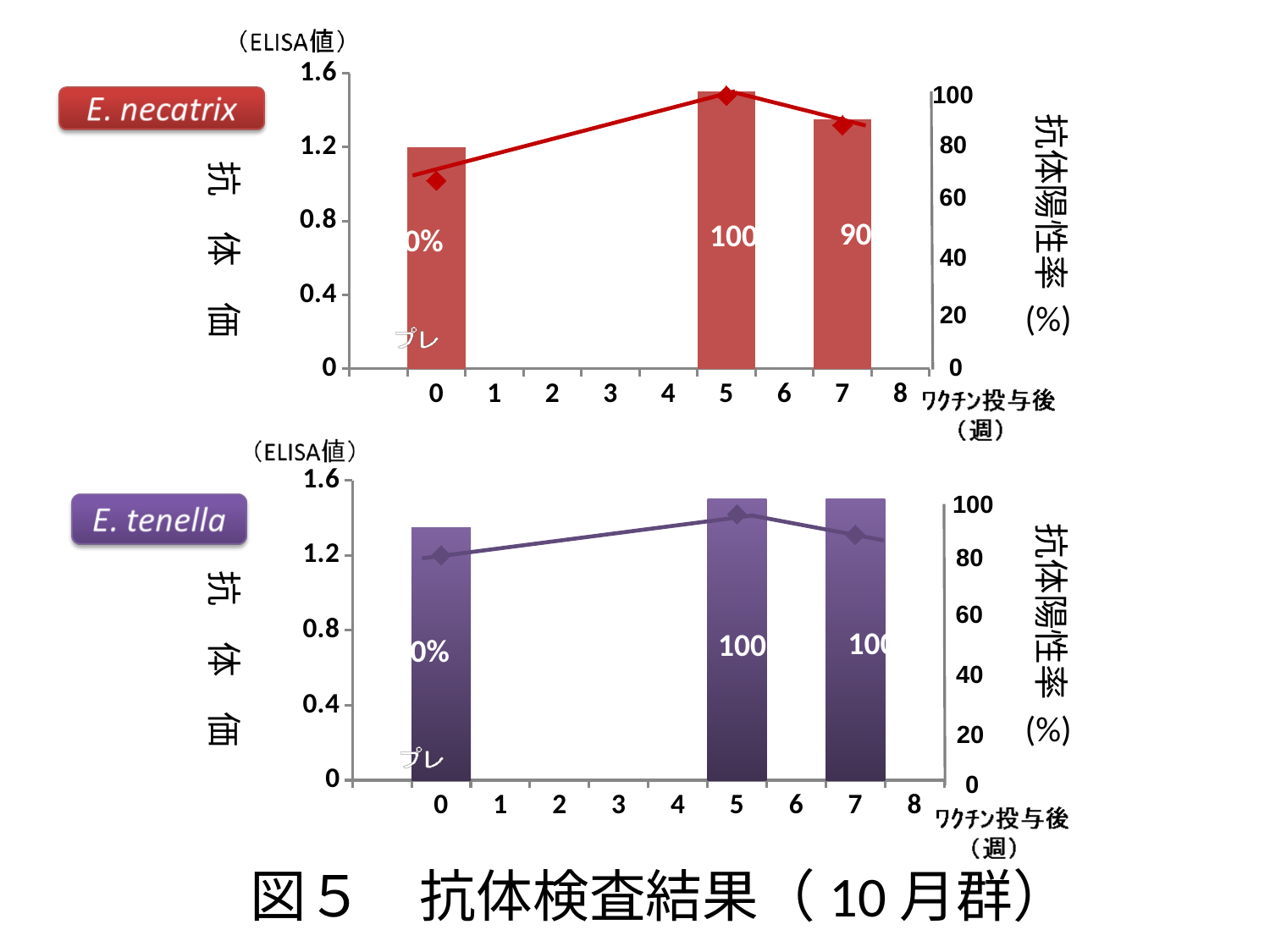
What kind of chart is the E. necatrix chart at the top of the slide? bar chart with a line overlay In the E. necatrix chart, what is the difference between the positive rates printed at week 5 and week 7? 10 In the E. tenella chart, is the antibody value bar at week 0 greater or less than 1.2? greater In the E. necatrix chart, is the antibody value bar at week 5 greater or less than 1.2? greater What is the label of the right-hand vertical axis on the E. tenella chart? 抗体陽性率（%） In the E. tenella chart, at which week is the antibody value bar lowest? 0 In the E. tenella chart, what antibody positive rate is printed on the bar at week 7? 100 In the E. necatrix chart, how many bars are plotted? 3 In the E. necatrix chart, what antibody positive rate is printed on the bar at week 5? 100 In the E. necatrix chart, what antibody positive rate is printed on the bar at week 7? 90 In the E. necatrix chart, at which week is the antibody value bar lowest? 0 In the E. necatrix chart, at which week is the antibody value bar highest? 5